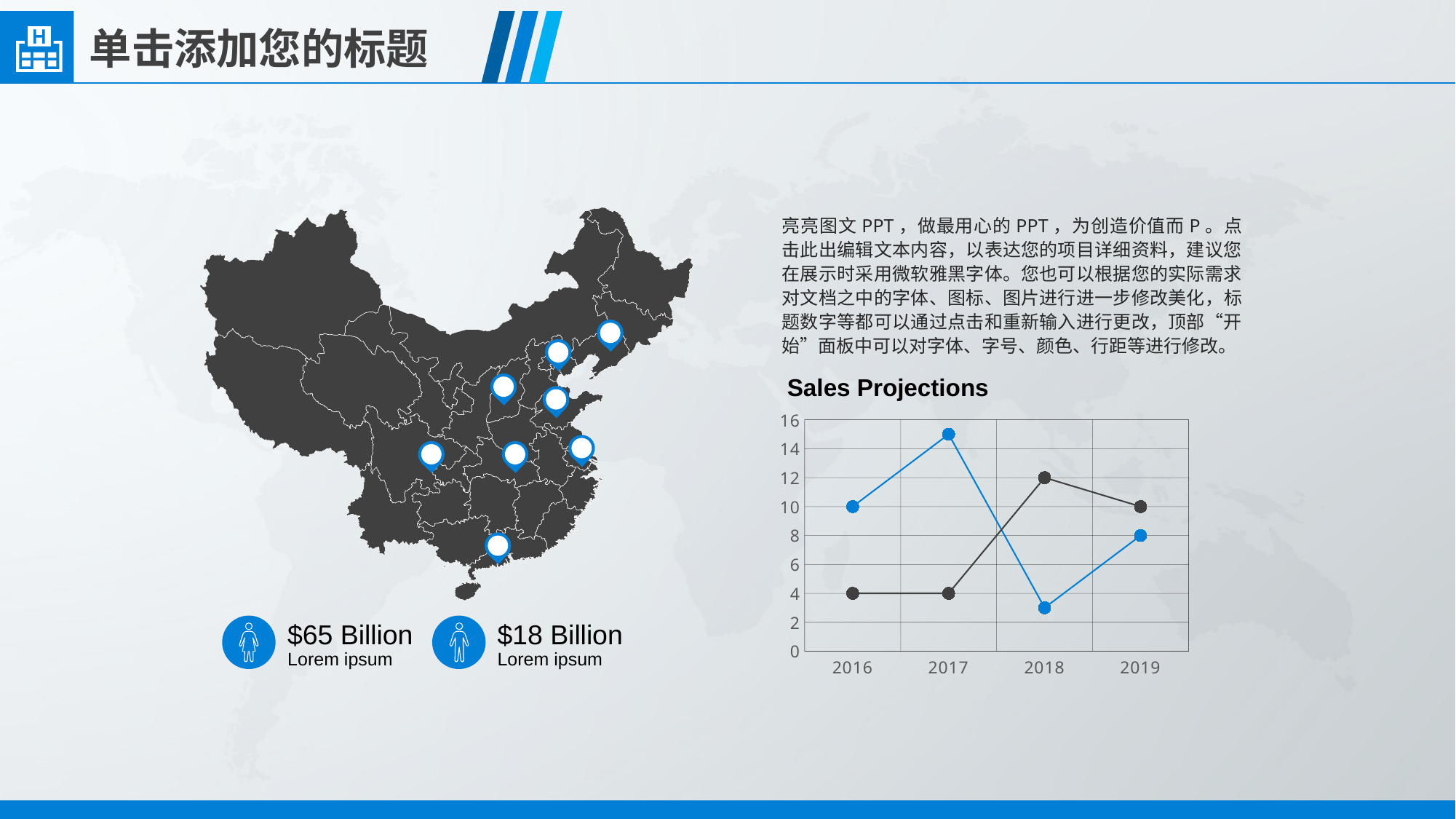
In the Sales Projections chart, what is the value of the blue line in 2016? 10 In the Sales Projections chart, what is the value of the dark grey line in 2019? 10 In the Sales Projections chart, is the value of the blue line in 2018 greater or less than 4? less In the Sales Projections chart, what is the value of the dark grey line in 2018? 12 In the Sales Projections chart, in which year does the dark grey line reach its highest value? 2018 How many years are shown on the x axis of the Sales Projections chart? 4 In the Sales Projections chart, what is the value of the blue line in 2019? 8 What is the title of the chart on the slide? Sales Projections In the Sales Projections chart, which line has the higher value in 2018, the blue line or the dark grey line? the dark grey line In the Sales Projections chart, what is the difference between the dark grey line's value in 2018 and its value in 2016? 8 What kind of chart is the Sales Projections chart? line chart In the Sales Projections chart, is the value of the blue line in 2017 greater or less than 14? greater